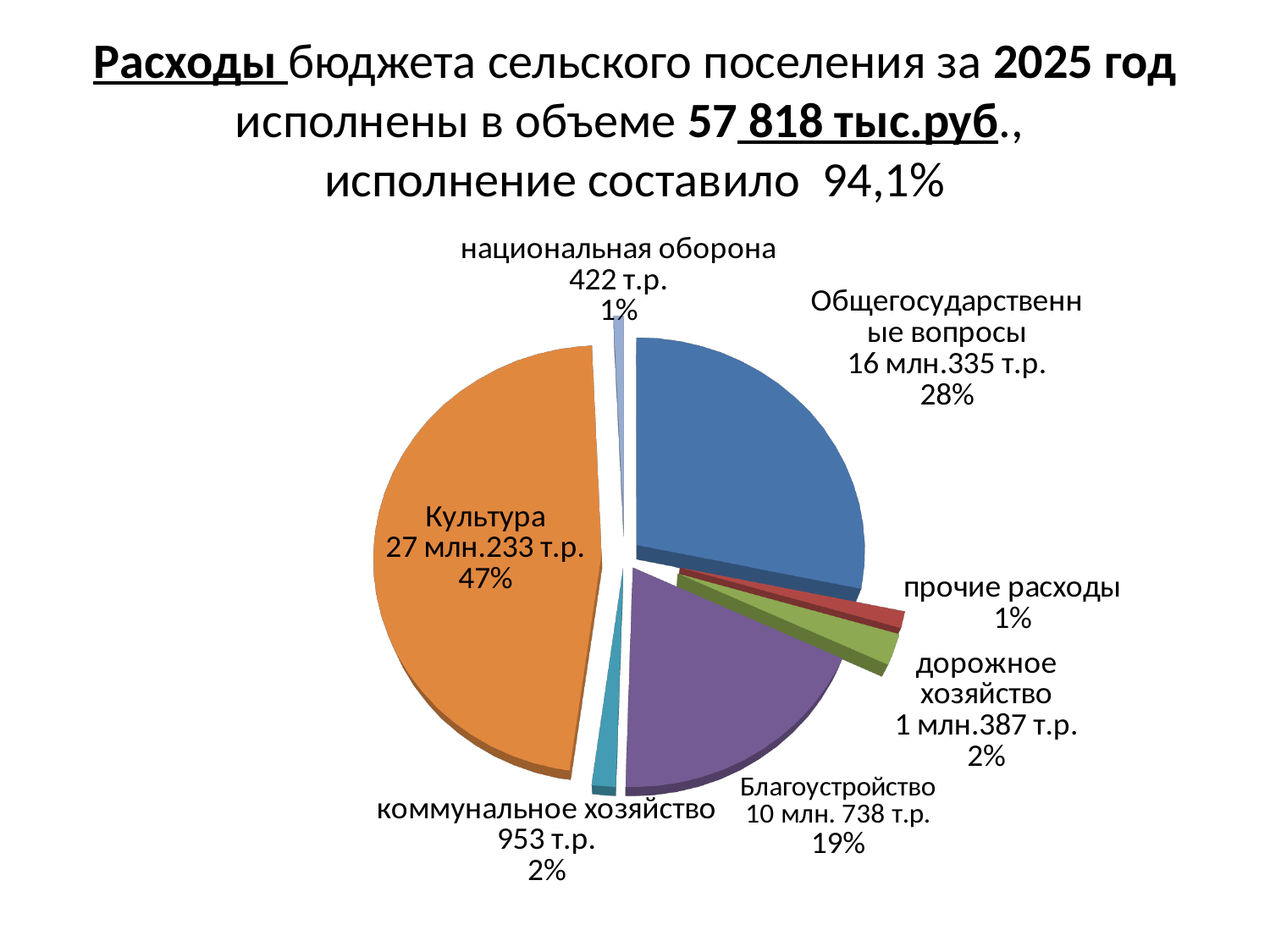
Какая сумма расходов указана для категории «коммунальное хозяйство»? 953 т.р. Какой тип диаграммы показан на слайде? круговая диаграмма Какую долю расходов составляет категория «Культура»? 47% Какая сумма расходов указана для категории «национальная оборона»? 422 т.р. Что больше: доля категории «Общегосударственные вопросы» или доля категории «Благоустройство»? Общегосударственные вопросы На сколько процентных пунктов доля категории «Культура» больше доли категории «Общегосударственные вопросы»? 19 Какая сумма расходов указана для категории «Общегосударственные вопросы»? 16 млн.335 т.р. Какая сумма расходов указана для категории «дорожное хозяйство»? 1 млн.387 т.р. Сколько категорий расходов показано на круговой диаграмме? 7 Какая категория расходов имеет наибольшую долю на диаграмме? Культура Какую долю расходов составляет категория «Благоустройство»? 19% Какую долю расходов составляет категория «прочие расходы»? 1%